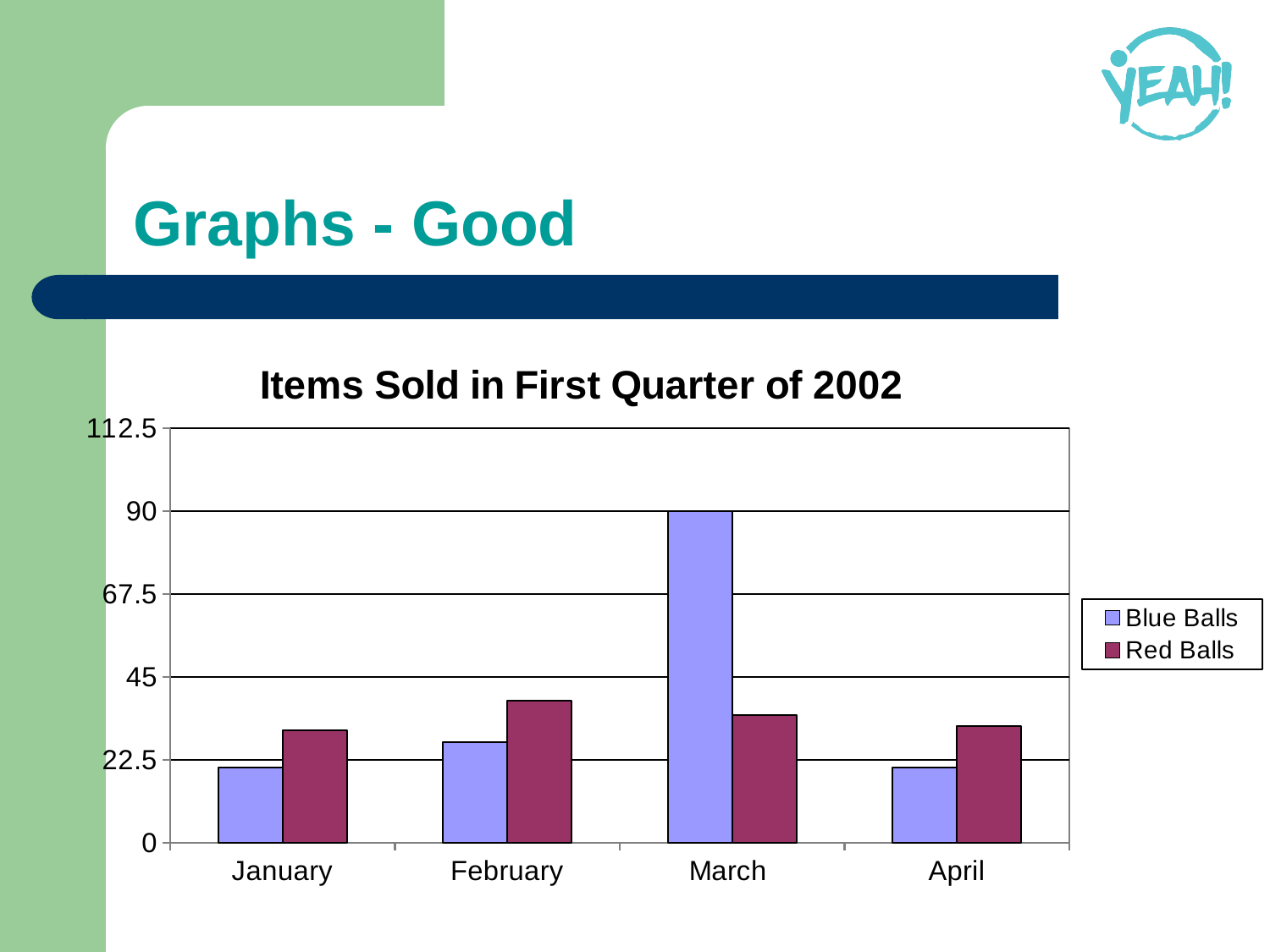
Is the value for Blue Balls in March greater or less than 67.5? greater How many series does the legend list? 2 How many months are shown on the x axis? 4 Which series has the larger value in March, Blue Balls or Red Balls? Blue Balls What is the title of the chart? Items Sold in First Quarter of 2002 In which month is the Blue Balls value highest? March What kind of chart is shown on the slide? bar chart Is the value for Red Balls in April greater or less than 22.5? greater What is the value for Blue Balls in March? 90 Which series has the larger value in January, Blue Balls or Red Balls? Red Balls What are the two series named in the legend? Blue Balls and Red Balls Is the value for Red Balls in February greater or less than 45? less